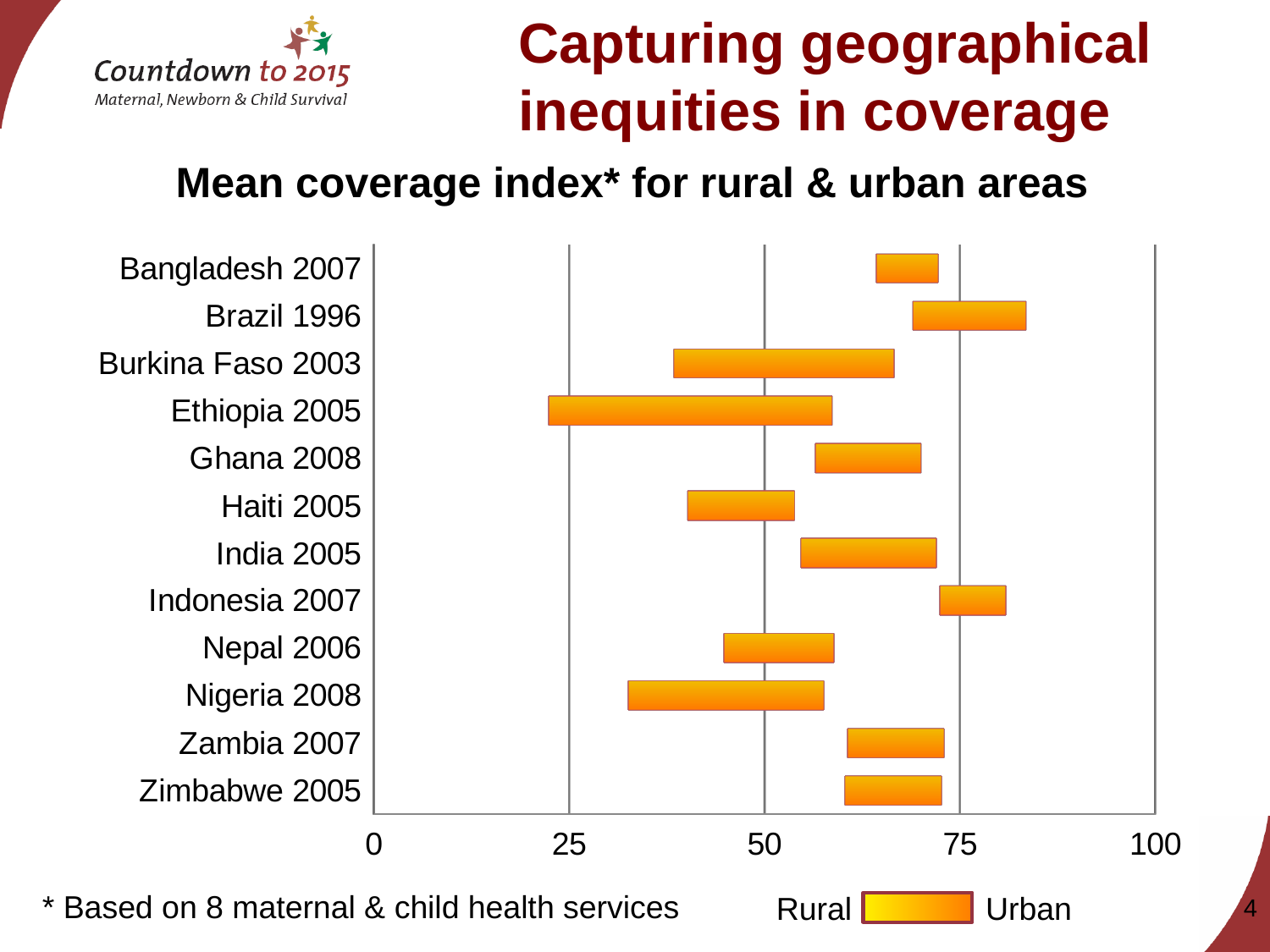
Which country has the highest urban coverage index? Brazil 1996 Is the rural coverage index for Zambia 2007 greater or less than 50? greater Which has the higher urban coverage index, Indonesia 2007 or Haiti 2005? Indonesia 2007 Which country has the lowest rural coverage index? Ethiopia 2005 What kind of chart is shown on the slide? bar chart Is the rural coverage index for Nigeria 2008 greater or less than 50? less Is the rural coverage index for Burkina Faso 2003 greater or less than 50? less How many countries (categories) are plotted on the chart? 12 What do the two ends of each bar represent, according to the legend? Rural and Urban Which country has the widest gap between its rural and urban coverage index? Ethiopia 2005 What is the title of the chart? Mean coverage index* for rural & urban areas